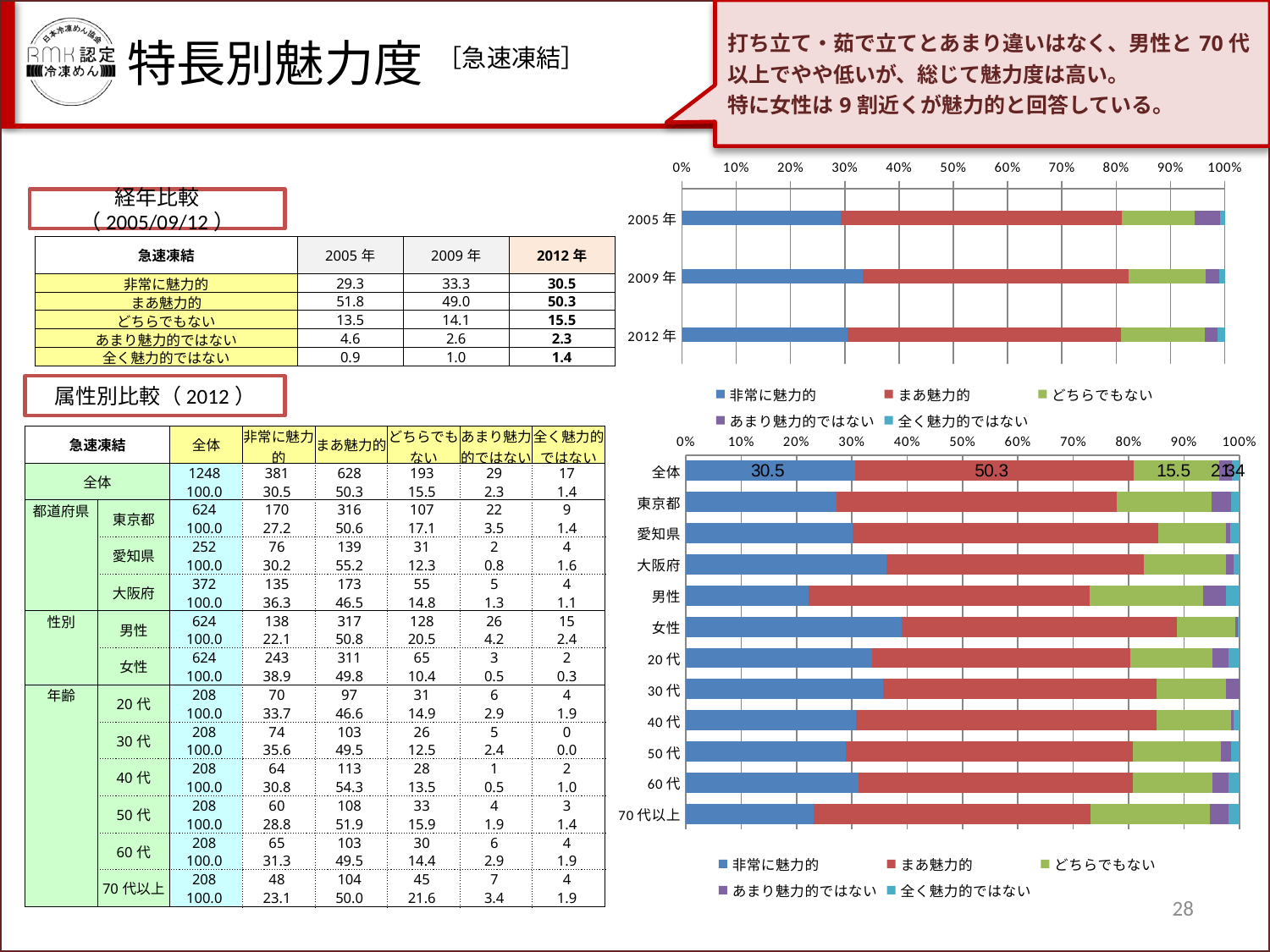
In the upper chart (経年比較), which year has the longest 非常に魅力的 segment? 2009年 In the lower chart (属性別比較), what is the value labelled for 非常に魅力的 on the 全体 bar? 30.5 How many category bars are plotted in the upper chart (経年比較)? 3 In the lower chart (属性別比較), which legend entry is shown in blue? 非常に魅力的 How many series does the legend of the lower chart (属性別比較) list? 5 In the lower chart (属性別比較), is the 非常に魅力的 segment for 男性 greater or less than 30%? less In the lower chart (属性別比較), what is the value labelled for どちらでもない on the 全体 bar? 15.5 In the lower chart (属性別比較), what is the value labelled for まあ魅力的 on the 全体 bar? 50.3 How many category bars are plotted in the lower chart (属性別比較)? 12 In the lower chart (属性別比較), is the 非常に魅力的 segment for 女性 greater or less than 30%? greater In the lower chart (属性別比較), which has the larger 非常に魅力的 segment, 男性 or 女性? 女性 What kind of chart is the chart on the right showing 2005年, 2009年 and 2012年? stacked bar chart